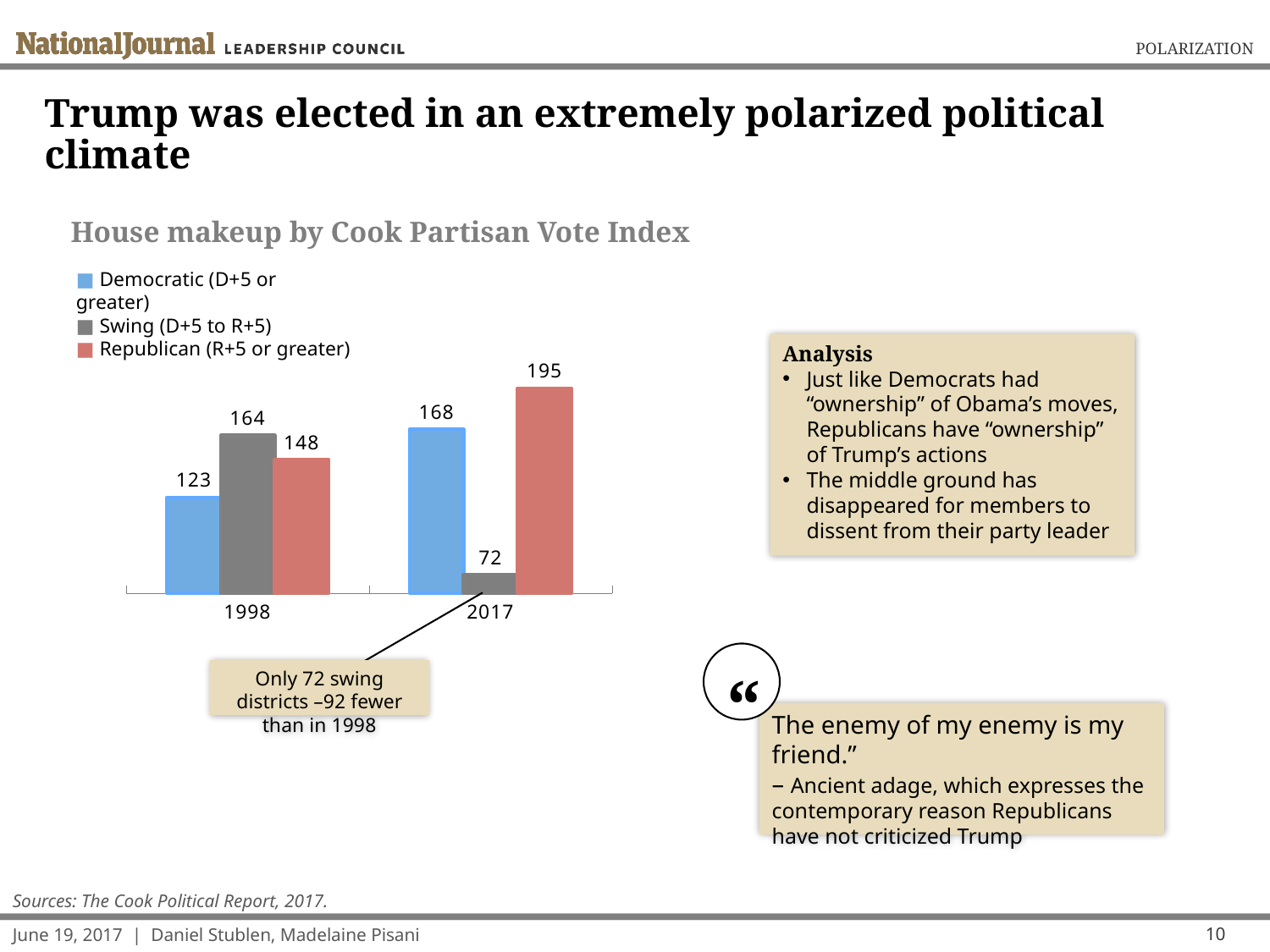
What is the title of the chart? House makeup by Cook Partisan Vote Index What is the value for Swing (D+5 to R+5) in 1998? 164 Which series has the lowest value in 2017? Swing (D+5 to R+5) What kind of chart is shown? bar chart How many series does the legend list? 3 How many year categories are shown on the x axis? 2 What is the difference between the Swing values in 1998 and 2017? 92 Which is larger, the Democratic value in 1998 or the Democratic value in 2017? 2017 Which series has the highest value in 2017? Republican (R+5 or greater) What is the difference between the Republican and Democratic values in 2017? 27 What is the value for Democratic (D+5 or greater) in 1998? 123 What is the value for Republican (R+5 or greater) in 2017? 195